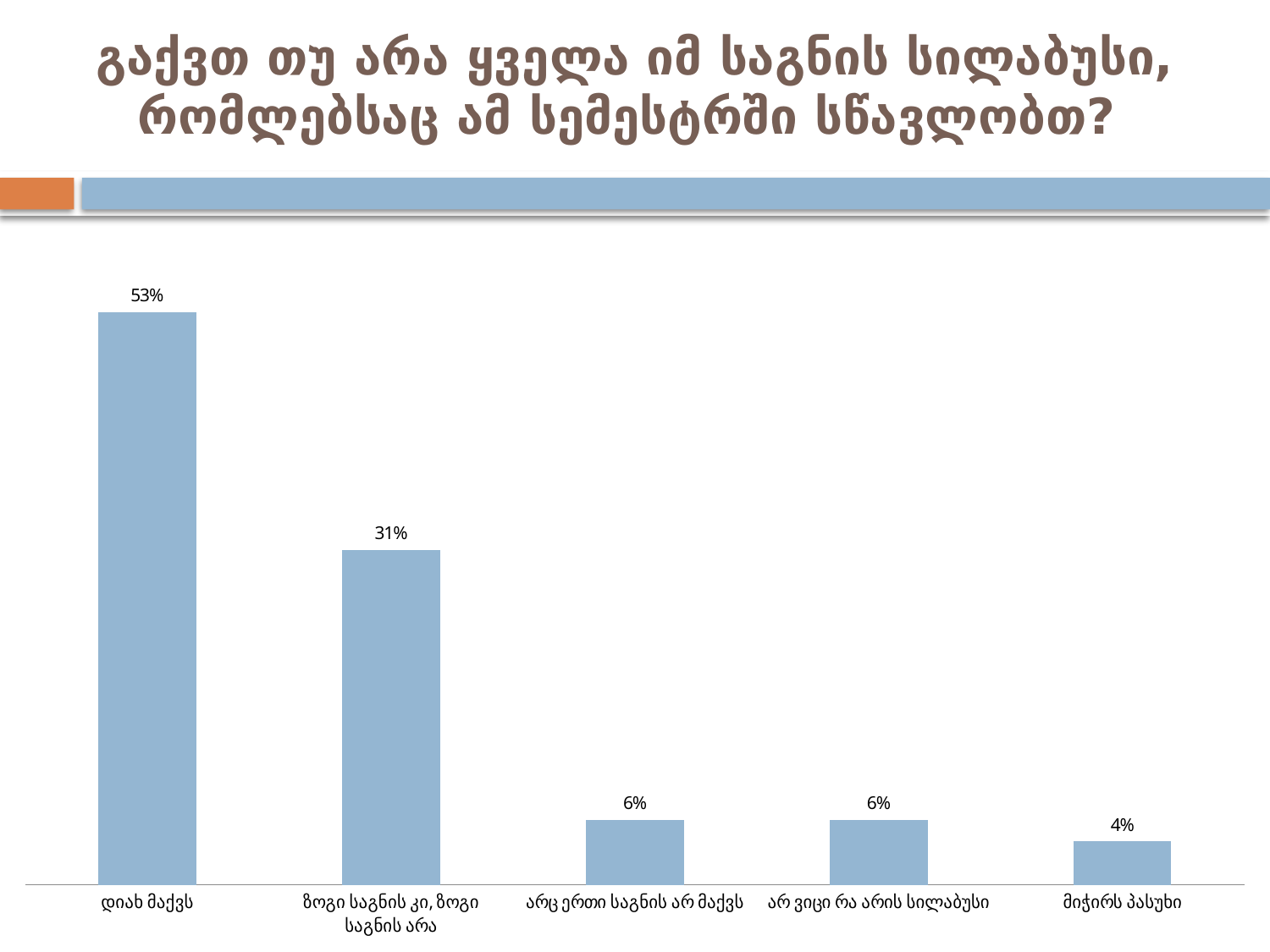
Which is larger, the value for "ზოგი საგნის კი, ზოგი საგნის არა" or the value for "არც ერთი საგნის არ მაქვს"? ზოგი საგნის კი, ზოგი საგნის არა How many categories are shown in the chart? 5 What is the difference between the values for "არც ერთი საგნის არ მაქვს" and "მიჭირს პასუხი"? 2% What is the value for "დიახ მაქვს"? 53% What kind of chart is shown on the slide? Bar chart What is the value for "ზოგი საგნის კი, ზოგი საგნის არა"? 31% What is the value for "მიჭირს პასუხი"? 4% What is the value for "არ ვიცი რა არის სილაბუსი"? 6% Which category has the highest value? დიახ მაქვს Which category has the lowest value? მიჭირს პასუხი What is the difference between the values for "დიახ მაქვს" and "ზოგი საგნის კი, ზოგი საგნის არა"? 22% Do the values rise or fall from left to right across the categories? Fall